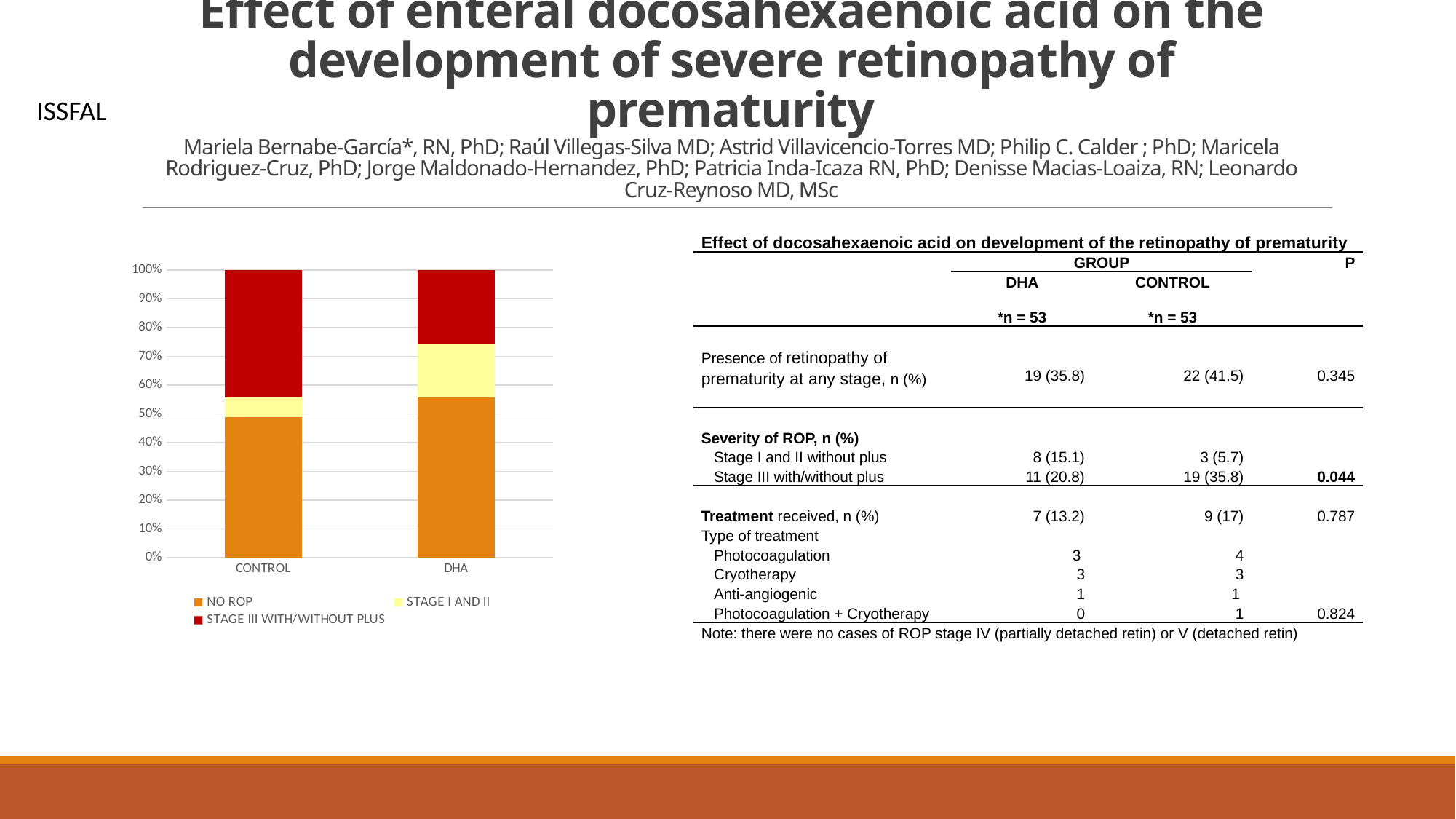
Which series takes up the smallest share of the CONTROL bar? STAGE I AND II Which group has the larger STAGE III WITH/WITHOUT PLUS share, CONTROL or DHA? CONTROL What are the two categories on the x axis of the chart? CONTROL and DHA Which series takes up the largest share of the DHA bar? NO ROP Which group has the larger STAGE I AND II share, CONTROL or DHA? DHA What is the total height of the CONTROL stacked bar? 100% How many categories are shown on the x axis of the chart? 2 How many series does the chart legend list? 3 What kind of chart is shown on the left of the slide? Stacked bar chart In the DHA bar, does the NO ROP segment reach greater or less than 50%? greater Which series in the chart is shown in dark red? STAGE III WITH/WITHOUT PLUS In the CONTROL bar, does the NO ROP segment reach greater or less than 40%? greater